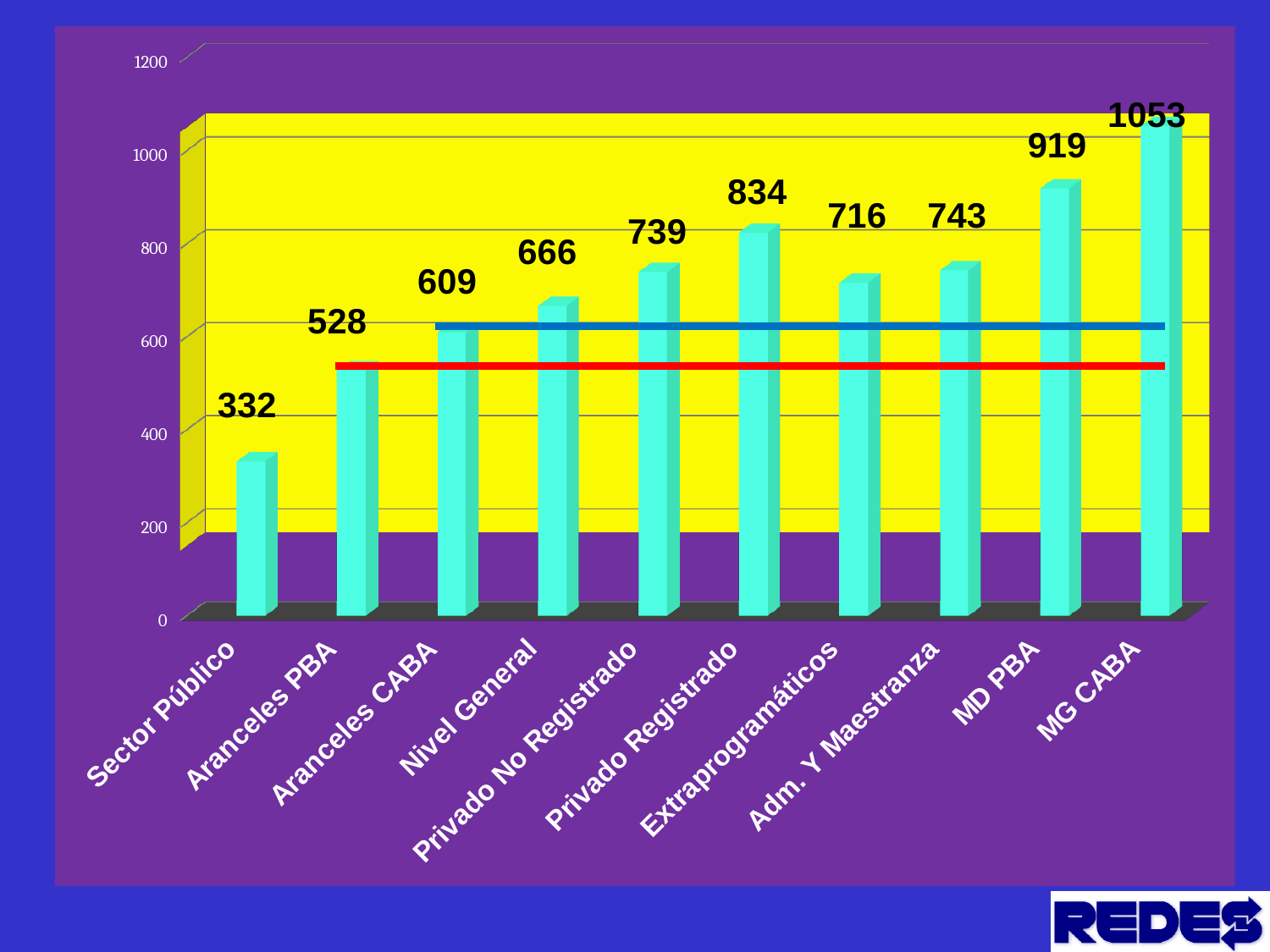
What colour are the bars in the chart? cyan What is the value for Adm. Y Maestranza? 743 What is the value for Sector Público? 332 How many categories are shown on the x axis? 10 Which category has the highest value? MG CABA Is the value for Aranceles CABA greater or less than 800? less Which category has the lowest value? Sector Público What is the value for Privado Registrado? 834 What is the difference between the values for MD PBA and Aranceles PBA? 391 What kind of chart is this? bar chart What is the difference between the values for Privado No Registrado and Nivel General? 73 Which is larger, the value for Nivel General or the value for Extraprogramáticos? Extraprogramáticos